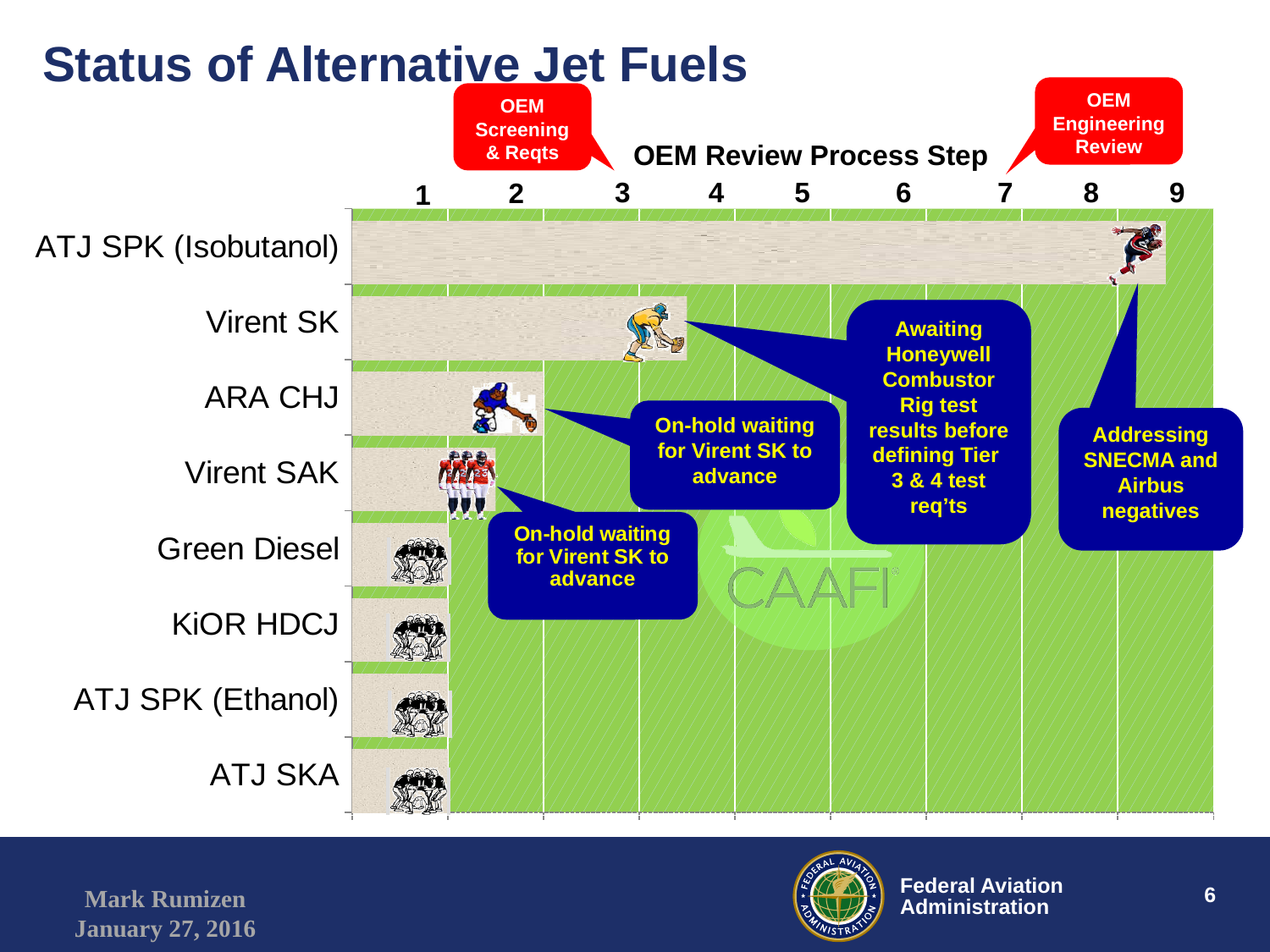
Which has progressed further in the OEM review process, Virent SK or ARA CHJ? Virent SK Which has progressed further in the OEM review process, ATJ SPK (Isobutanol) or Virent SK? ATJ SPK (Isobutanol) Which fuel has progressed furthest along the OEM Review Process Step axis? ATJ SPK (Isobutanol) How many alternative jet fuels are listed on the chart? 8 Is the value for ARA CHJ greater or less than 4? less What kind of chart is shown on the slide? bar chart Is the value for Virent SK greater or less than 2? greater What is the title of the slide? Status of Alternative Jet Fuels Is the value for Green Diesel greater or less than 3? less What is the title of the horizontal axis of the chart? OEM Review Process Step